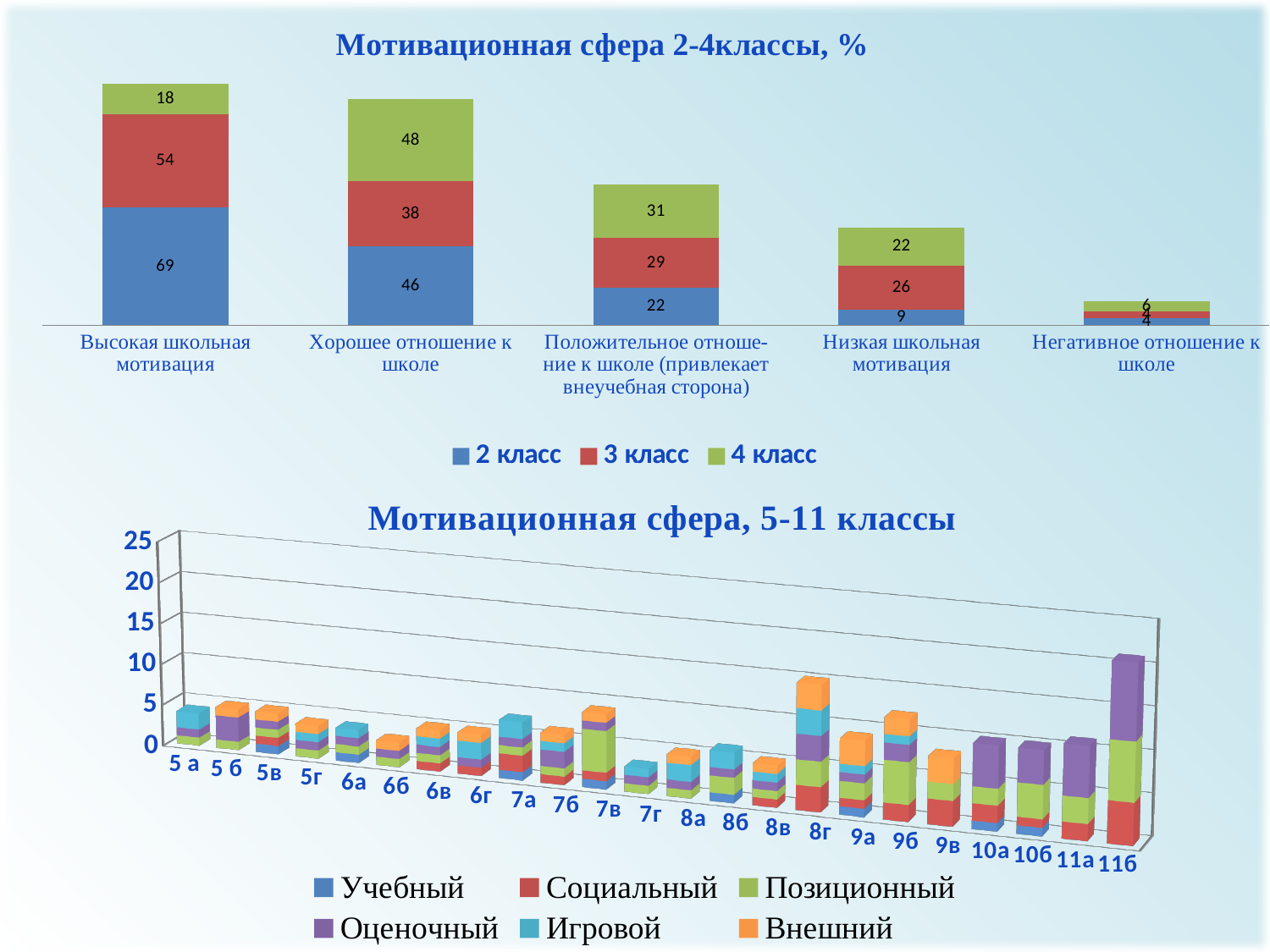
In the chart 'Мотивационная сфера 2-4классы, %', what is the total of the stacked bar for 'Высокая школьная мотивация'? 141 How many categories are shown on the x axis of the chart 'Мотивационная сфера 2-4классы, %'? 5 In the chart 'Мотивационная сфера 2-4классы, %', what is the value for 4 класс in the category 'Хорошее отношение к школе'? 48 In the chart 'Мотивационная сфера, 5-11 классы', which class has the tallest stacked bar? 11б In the chart 'Мотивационная сфера 2-4классы, %', what is the value for 2 класс in the category 'Высокая школьная мотивация'? 69 How many series does the legend of the chart 'Мотивационная сфера, 5-11 классы' list? 6 What kind of chart is 'Мотивационная сфера, 5-11 классы'? Stacked bar chart In the chart 'Мотивационная сфера 2-4классы, %', for the category 'Положительное отношение к школе (привлекает внеучебная сторона)', which is larger: the 3 класс value or the 4 класс value? 4 класс In the chart 'Мотивационная сфера 2-4классы, %', which category has the highest value for 2 класс? Высокая школьная мотивация How many series does the legend of the chart 'Мотивационная сфера 2-4классы, %' list? 3 In the chart 'Мотивационная сфера 2-4классы, %', what is the value for 3 класс in the category 'Низкая школьная мотивация'? 26 In the chart 'Мотивационная сфера 2-4классы, %', what is the difference between the 2 класс and 3 класс values for 'Высокая школьная мотивация'? 15